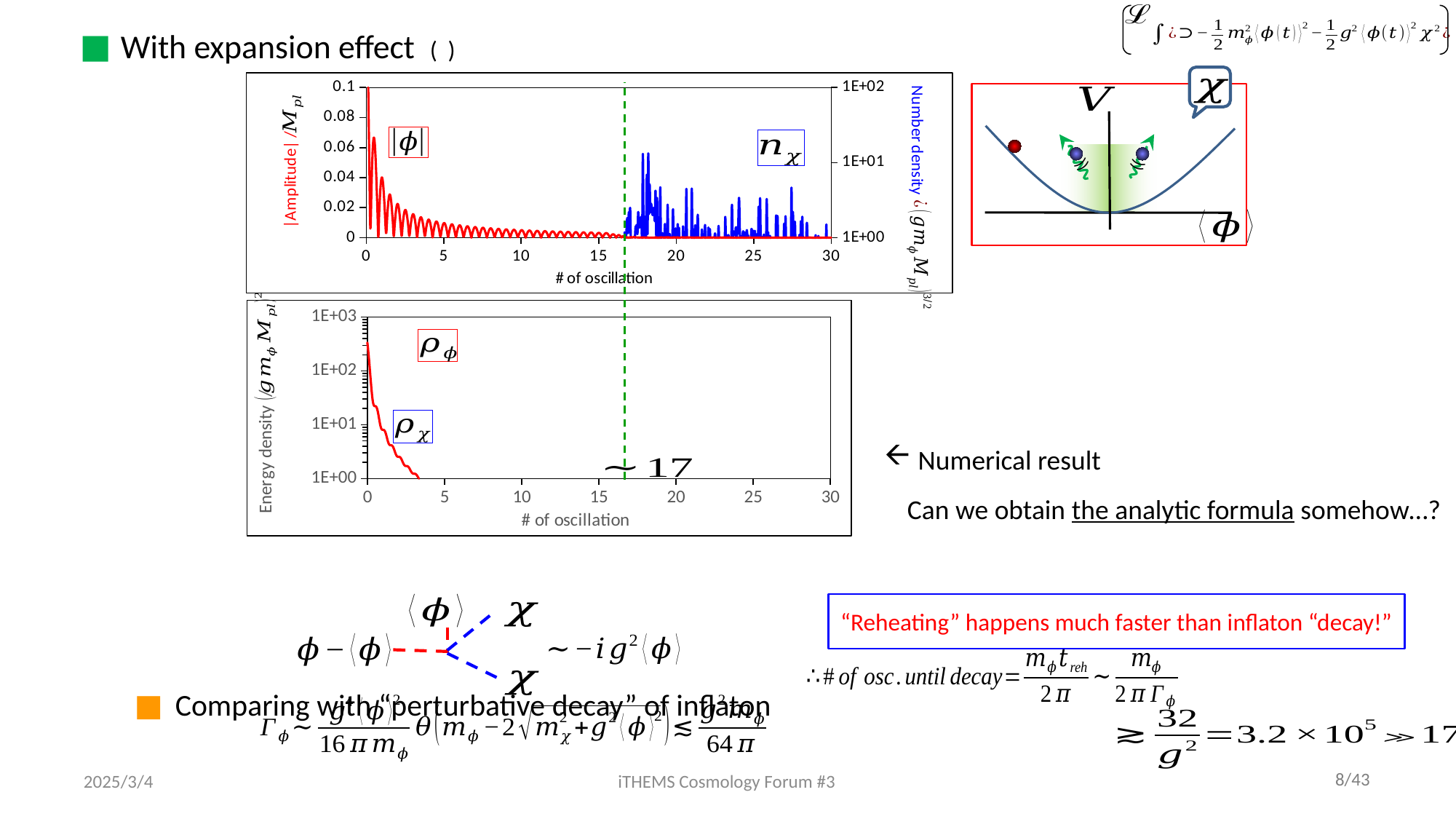
In the top chart, is the number density n_χ at 10 oscillations greater or less than 1E+01? less In the top chart, how many series are plotted (|φ| and n_χ)? 2 In the bottom chart (Energy density), is ρ_φ at 0 oscillations greater or less than 1E+02? greater In the top chart, what is the maximum value shown on the left y axis (|Amplitude|/M_pl)? 0.1 In the bottom chart (Energy density), what is the highest tick shown on the y axis? 1E+03 In the bottom chart (Energy density), does ρ_φ rise or fall as the number of oscillations increases? fall In the top chart, what is the label of the x axis? # of oscillation What kind of chart is the top chart showing |φ| and n_χ? line chart In the top chart, what colour is the |φ| amplitude line? red In the top chart, what is the highest tick shown on the right y axis (Number density)? 1E+02 In the top chart, is the |φ| amplitude at 10 oscillations greater or less than 0.02? less In the top chart, does the |φ| amplitude rise or fall as the number of oscillations increases? fall